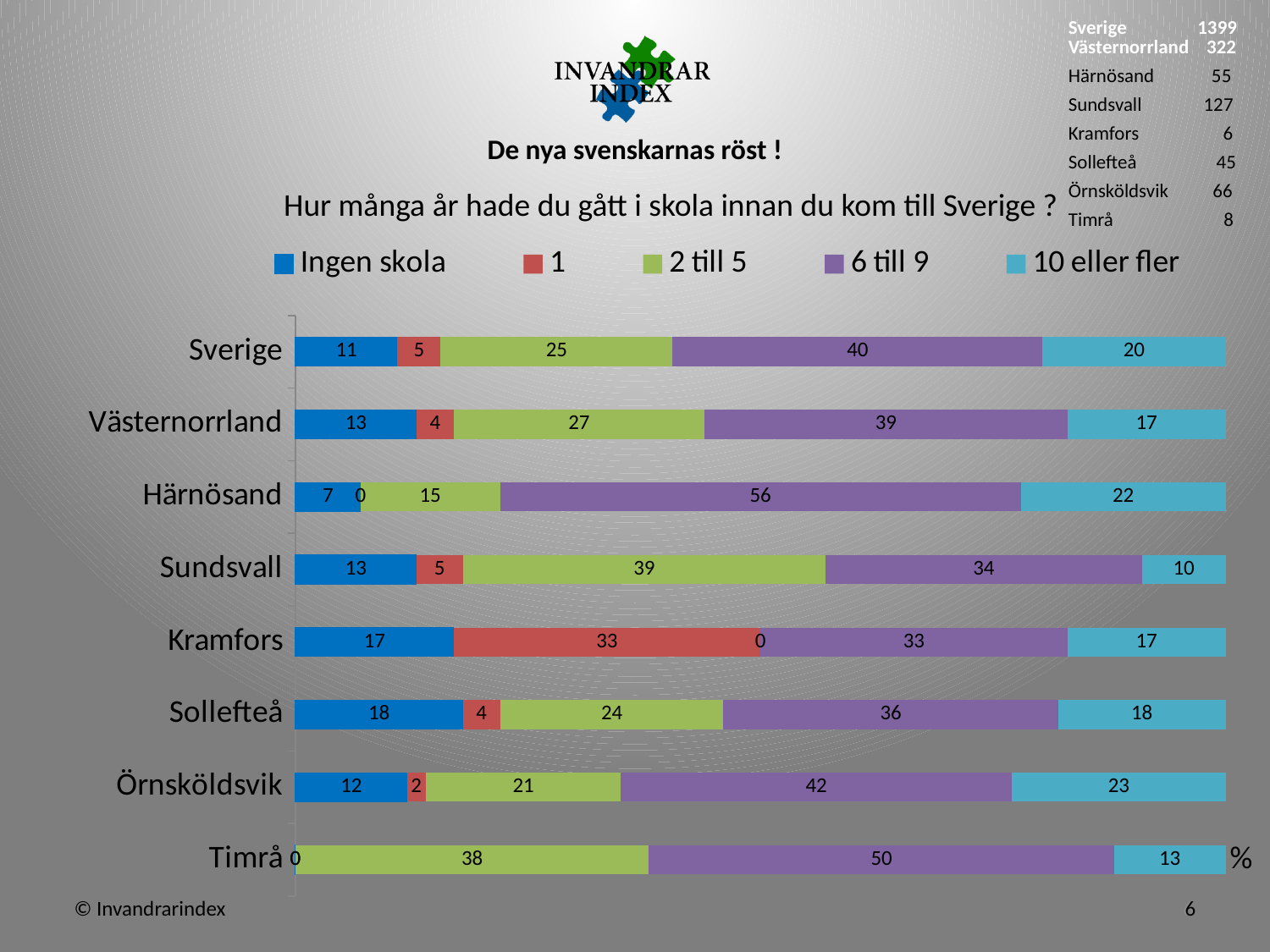
Which is larger: the '10 eller fler' value for Örnsköldsvik or for Sverige? Örnsköldsvik What is the value for the series '1' for Kramfors? 33 Which category has the highest value for '6 till 9'? Härnösand What is the value for '6 till 9' for Sverige? 40 Which category has the lowest value for '10 eller fler'? Sundsvall What kind of chart is shown on the slide? Stacked bar chart What is the total of the stacked bar for Västernorrland? 100 What is the difference between the '2 till 5' value for Sundsvall and the '2 till 5' value for Sverige? 14 What is the value for '10 eller fler' for Örnsköldsvik? 23 What is the value for '6 till 9' for Härnösand? 56 How many series does the legend list? 5 How many categories are shown on the chart? 8